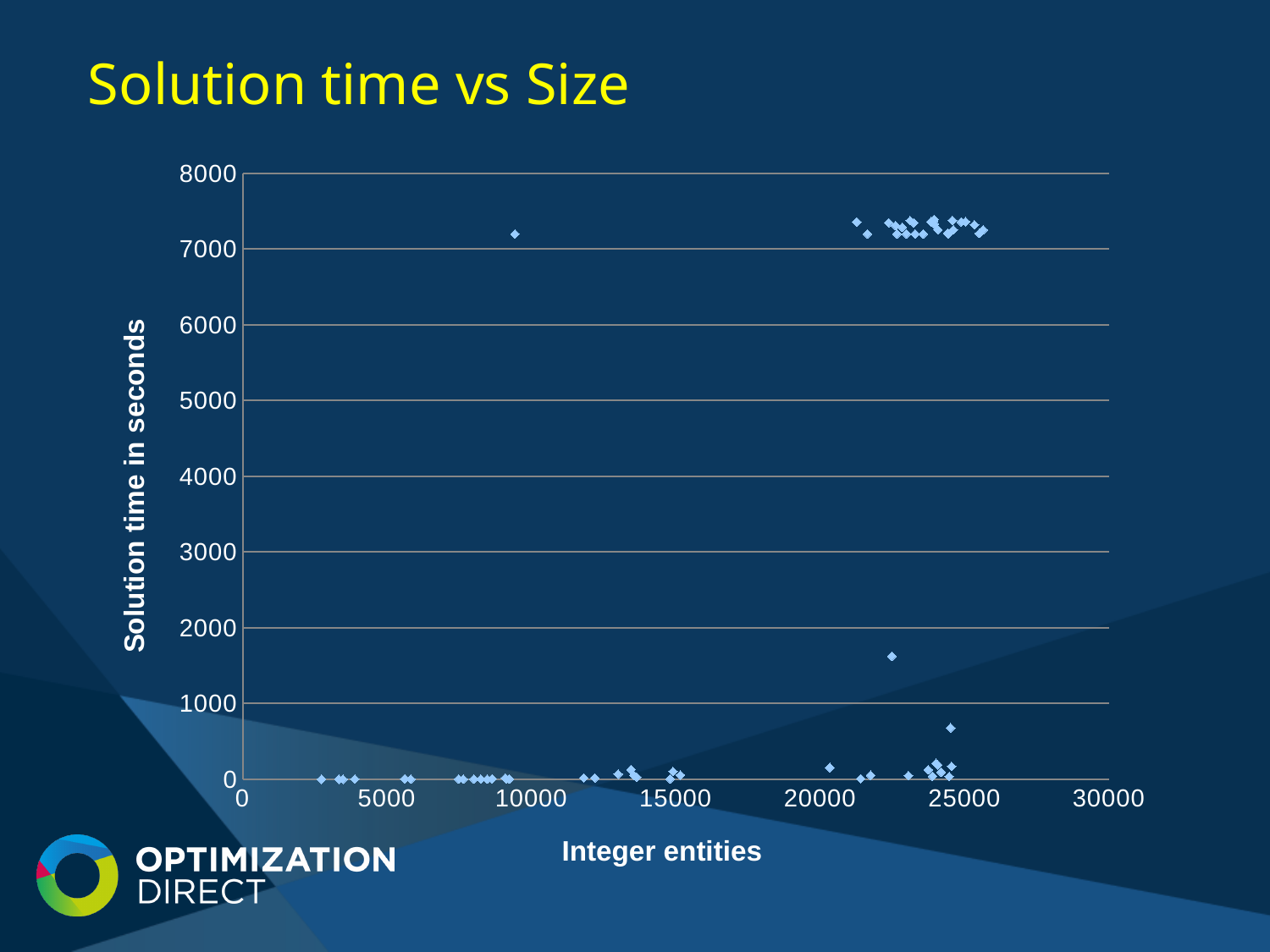
What is the highest value shown on the vertical axis of the chart? 8000 Is the solution time for the point near 25000 integer entities that sits between the 0 and 1000 gridlines greater or less than 1000 seconds? less Is the solution time for the isolated point near 22500 integer entities greater or less than 2000 seconds? less Is the solution time for the cluster of points between 21000 and 26000 integer entities near the top of the chart greater or less than 8000 seconds? less What is the title of the chart? Solution time vs Size What is the label on the vertical axis of the chart? Solution time in seconds What kind of chart is shown on the slide? scatter chart What is the highest value shown on the horizontal axis of the chart? 30000